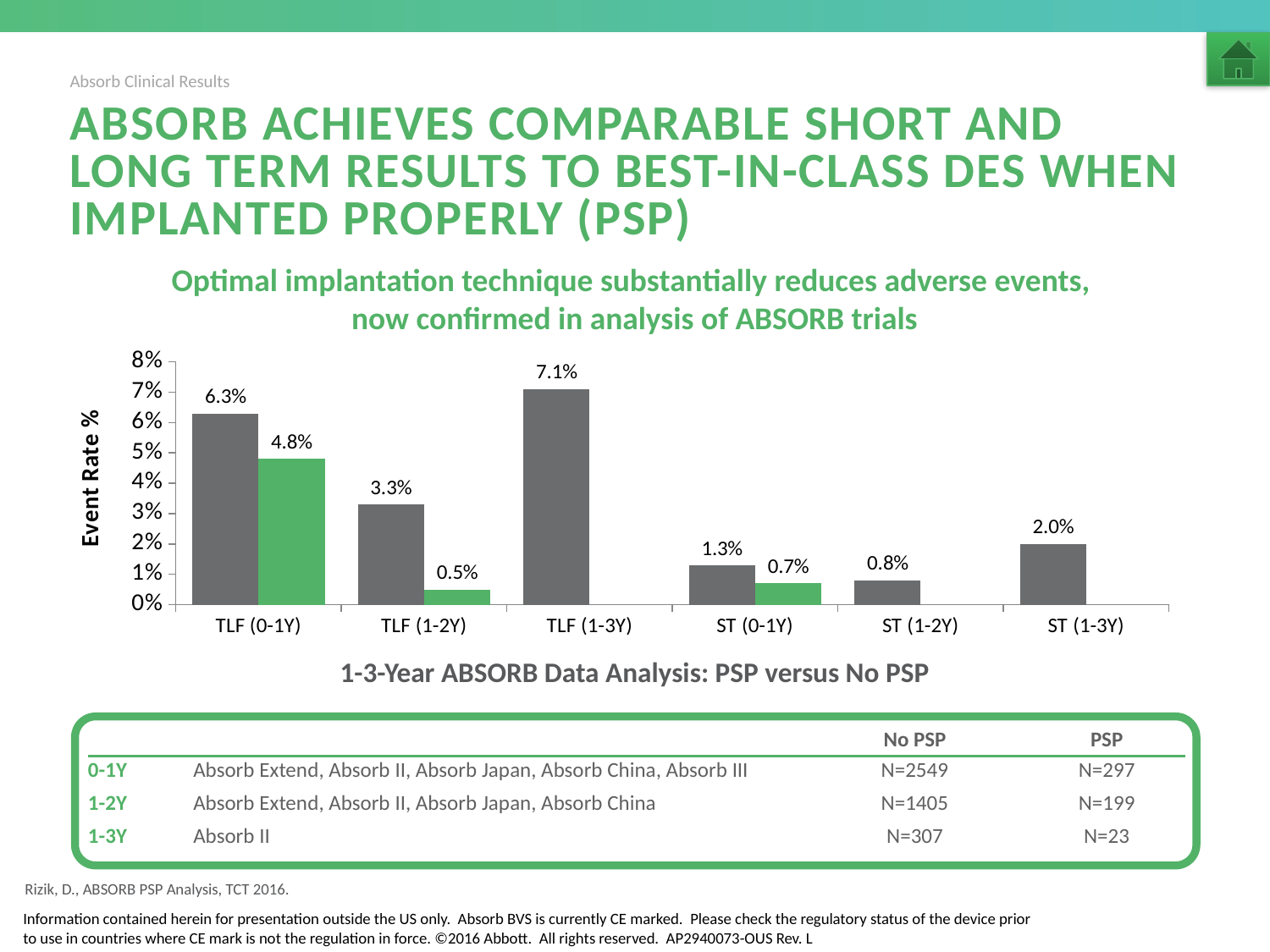
Which is larger: the gray bar for ST (1-3Y) or the gray bar for ST (1-2Y)? ST (1-3Y) What is the value of the gray bar for TLF (0-1Y)? 6.3% What is the lowest value labeled on the chart? 0.5% What is the title of the y axis of the chart? Event Rate % What is the value of the green bar for TLF (0-1Y)? 4.8% What is the value of the gray bar for TLF (1-3Y)? 7.1% What is the value of the green bar for ST (0-1Y)? 0.7% What is the difference between the gray bar and the green bar for TLF (1-2Y)? 2.8% How many categories are shown on the x axis of the chart? 6 Is the value of the gray bar for ST (1-2Y) greater or less than 1%? less What is the difference between the gray bar and the green bar for TLF (0-1Y)? 1.5% Which category has the highest gray bar? TLF (1-3Y)